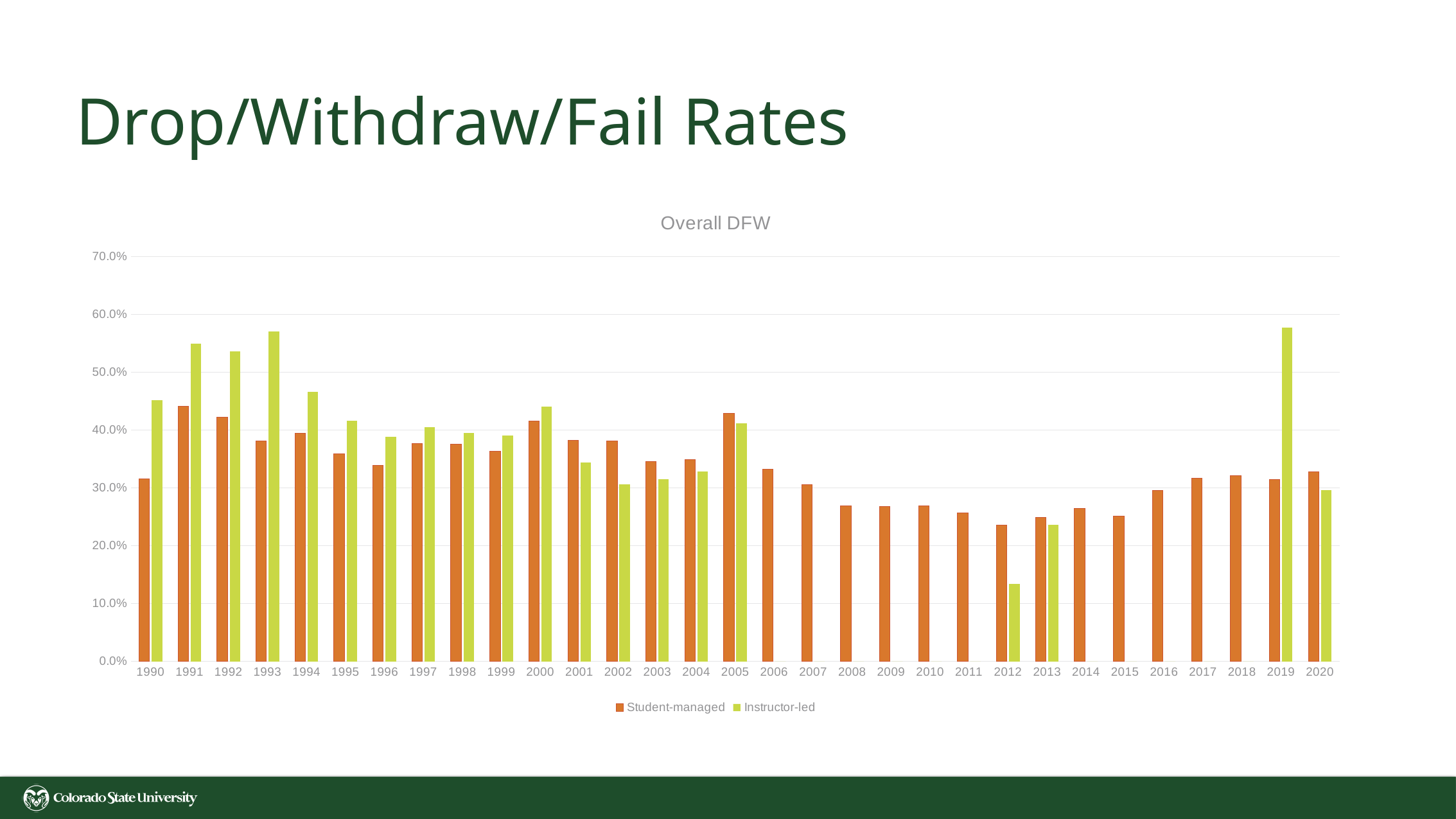
In 1990, which series has the larger value, Student-managed or Instructor-led? Instructor-led How many series does the legend list? 2 Which year has the lowest Instructor-led value? 2012 What is the title of the chart? Overall DFW What type of chart is shown on the slide? bar chart Is the Instructor-led value for 1993 greater or less than 50%? greater In 2002, which series has the larger value, Student-managed or Instructor-led? Student-managed How many years are shown on the x axis? 31 Which year has the lowest Student-managed value? 2012 Is the Student-managed value for 1991 greater or less than 40%? greater Is the Student-managed value for 2008 greater or less than 30%? less